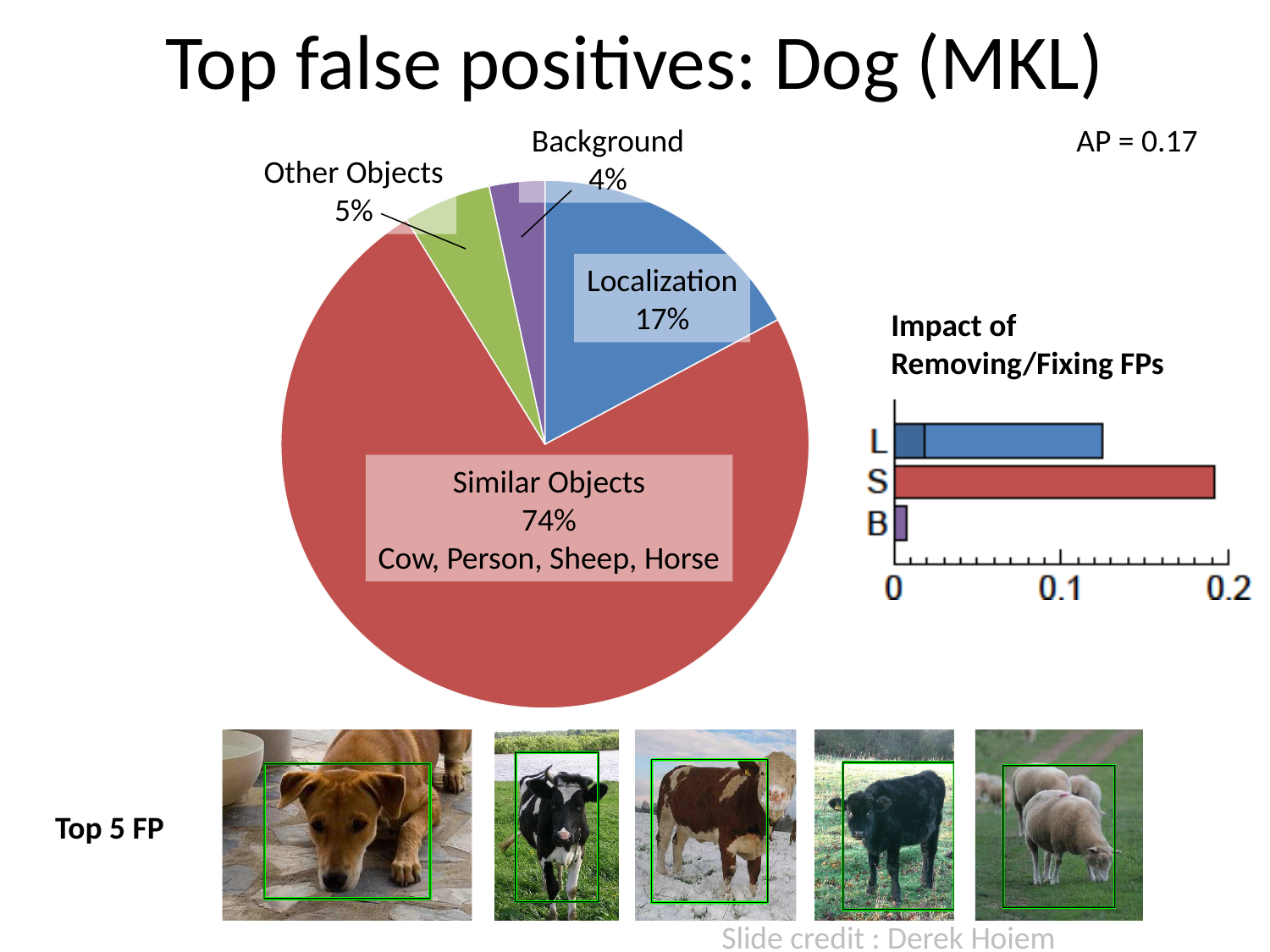
In the pie chart, which is larger: Other Objects or Background? Other Objects In the pie chart, what percentage is labelled for Localization? 17% In the pie chart, which category has the largest slice? Similar Objects In the pie chart, which category has the smallest slice? Background In the pie chart, what percentage is labelled for Background? 4% What kind of chart is the chart titled 'Impact of Removing/Fixing FPs'? bar chart In the 'Impact of Removing/Fixing FPs' bar chart, is the value for B greater or less than 0.1? less In the 'Impact of Removing/Fixing FPs' bar chart, which bar is the longest? S In the pie chart, how many percentage points larger is the Similar Objects slice than the Localization slice? 57 In the pie chart, what share of false positives is attributed to Similar Objects? 74% How many slices does the pie chart have? 4 In the 'Impact of Removing/Fixing FPs' bar chart, is the value for L greater or less than 0.1? greater